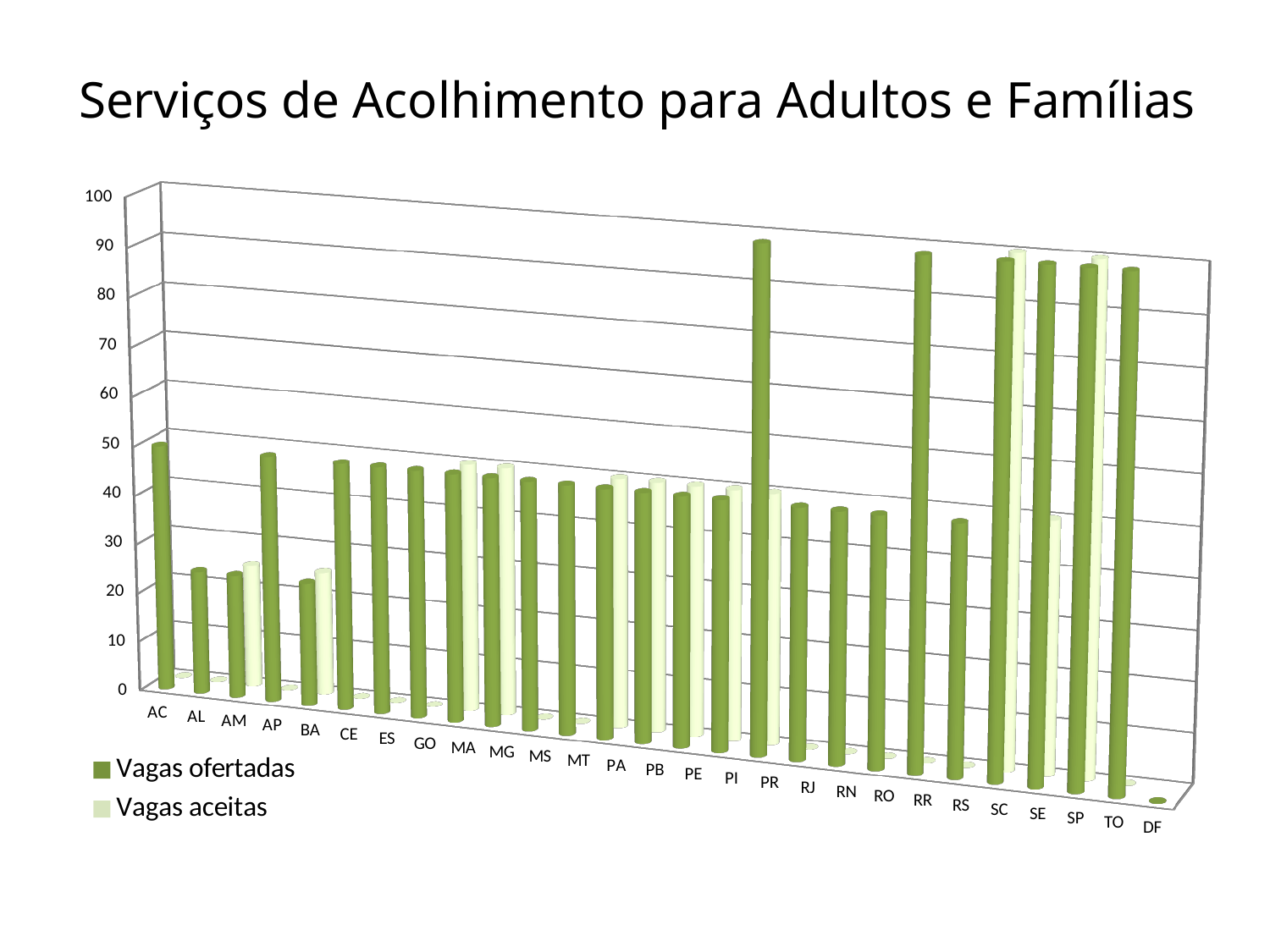
How many categories are shown on the x axis? 27 Which is larger, Vagas ofertadas for PR or Vagas ofertadas for RS? PR Which category has the lowest value for Vagas ofertadas? DF What is the title of the chart? Serviços de Acolhimento para Adultos e Famílias Is the value of Vagas aceitas for SC greater or less than 80? greater Is the value of Vagas ofertadas for AC greater or less than 40? greater Is the value of Vagas ofertadas for AL greater or less than 30? less How many series does the legend list? 2 What kind of chart is shown on the slide? bar chart Which is larger, Vagas aceitas for SC or Vagas aceitas for SE? SC